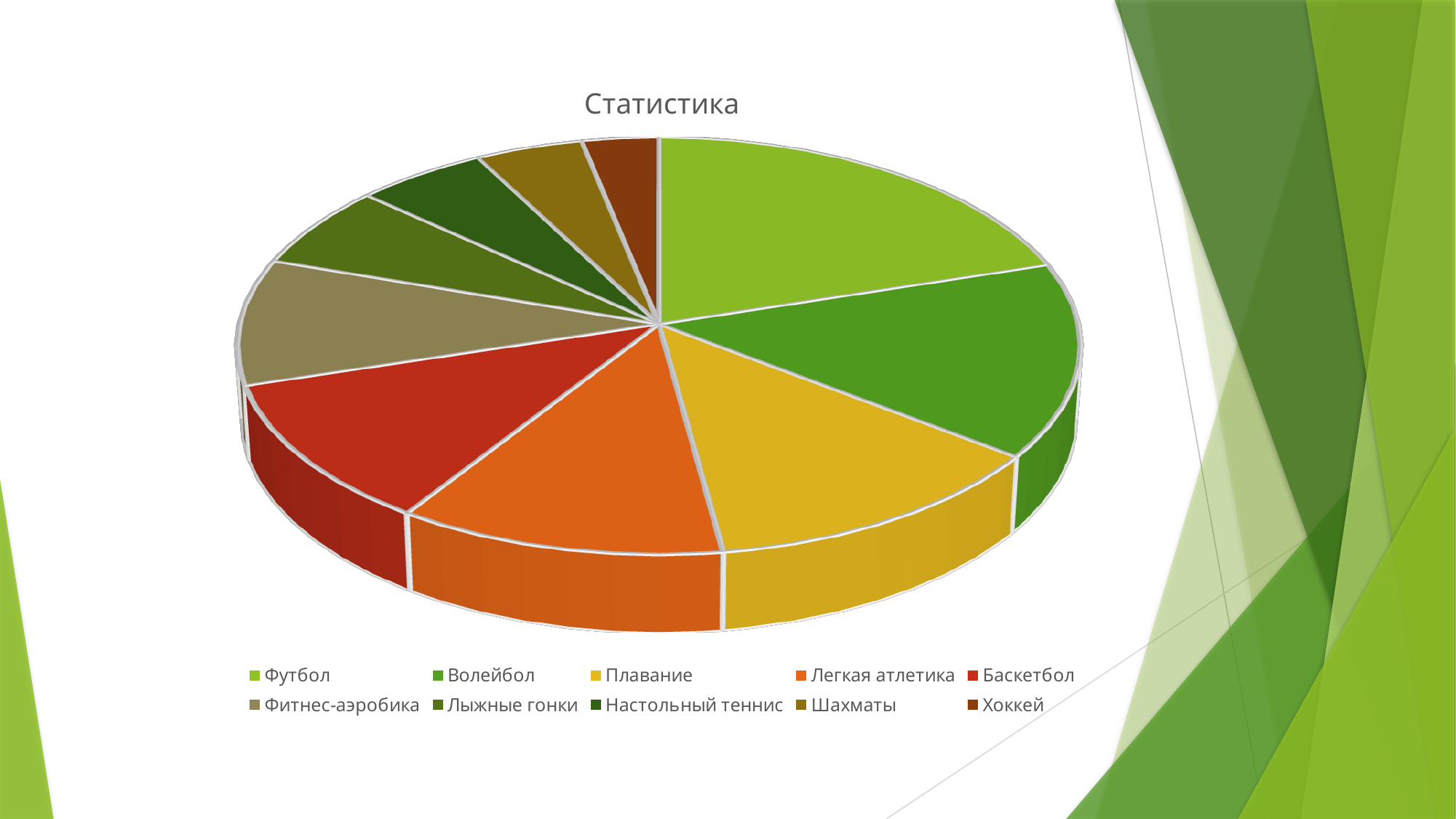
Which slice is larger, Плавание or Настольный теннис? Плавание Which category has the largest slice of the pie? Футбол Which slice is larger, Баскетбол or Хоккей? Баскетбол How many categories does the pie chart have? 10 Which slice is larger, Волейбол or Шахматы? Волейбол What kind of chart is shown on the slide? pie chart What is the title of the chart? Статистика Which category is shown in the orange colour in the legend? Легкая атлетика Which category has the smallest slice of the pie? Хоккей